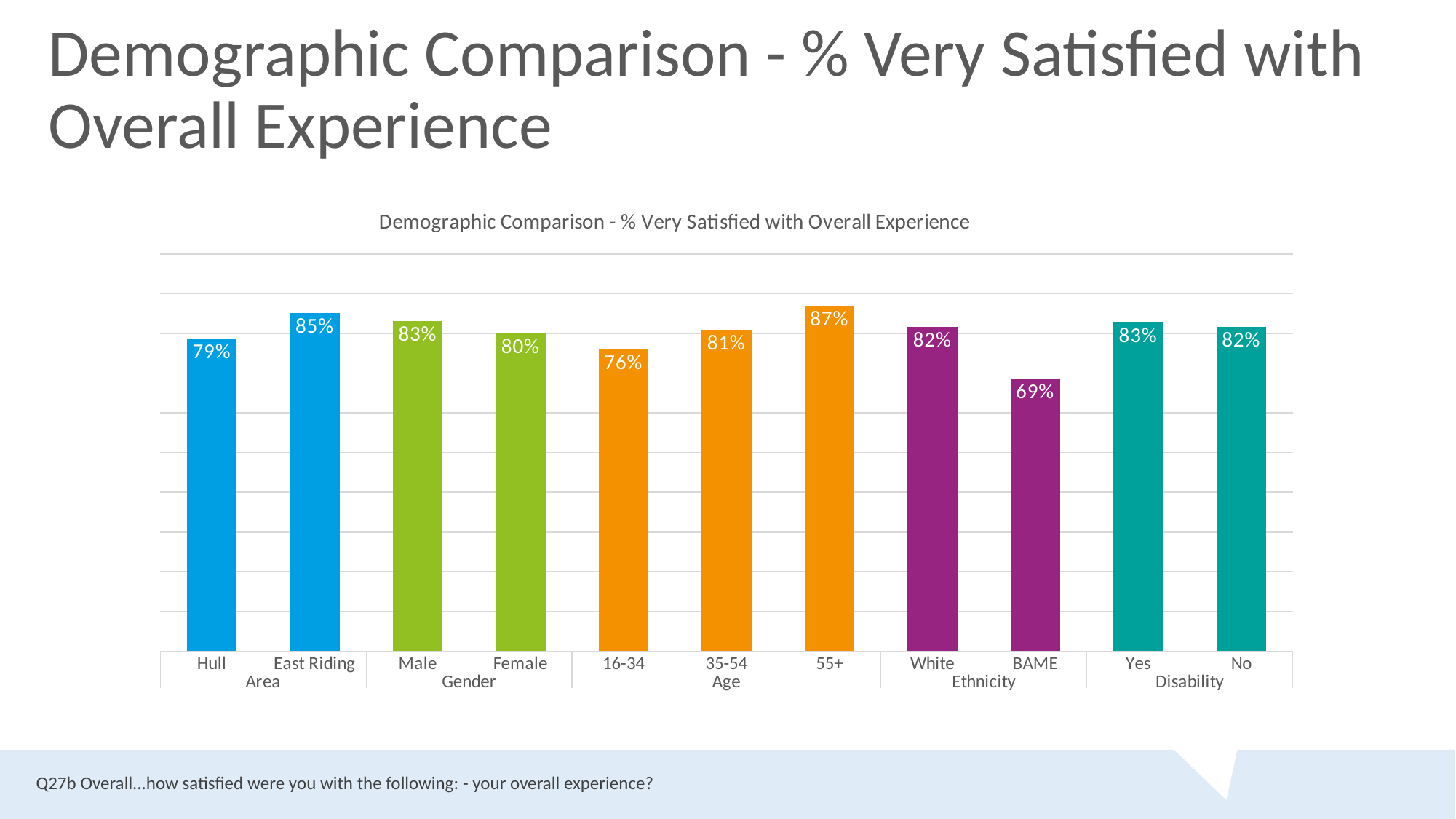
What is the difference between White and BAME? 13% What kind of chart is shown? Bar chart What is the value for BAME? 69% Which category has the highest value? 55+ What is the difference between East Riding and Hull? 6% What is the value for Hull? 79% What is the value for Female? 80% Which is larger, the value for Male or the value for Female? Male Do the values rise or fall across the three age groups from 16-34 to 55+? Rise Which category has the lowest value? BAME What is the value for the 55+ age group? 87% How many bars are plotted on the chart? 11